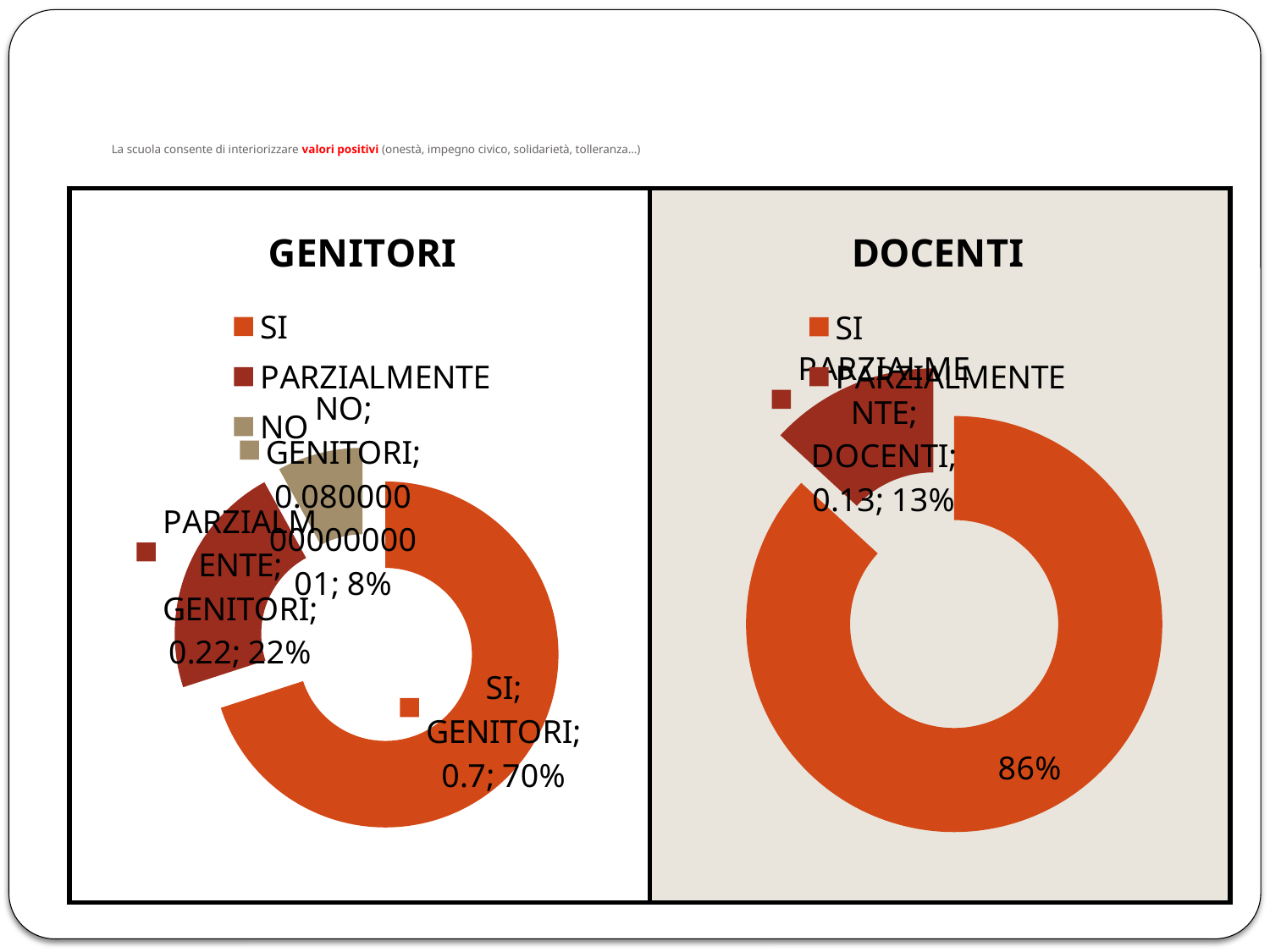
In the GENITORI chart, what is the difference in percentage points between PARZIALMENTE and NO? 14 How many entries does the legend of the GENITORI chart list? 3 In the GENITORI chart, what percentage is shown for PARZIALMENTE? 22% Which chart shows a larger share for PARZIALMENTE, GENITORI or DOCENTI? GENITORI What is the difference in percentage points between SI in the DOCENTI chart and SI in the GENITORI chart? 16 In the DOCENTI chart, what percentage is shown for SI? 86% In the DOCENTI chart, what percentage is shown for PARZIALMENTE? 13% What type of chart is the DOCENTI chart? Doughnut chart In the GENITORI chart, what percentage is shown for SI? 70% In the GENITORI chart, which category has the smallest share? NO In the GENITORI chart, which category has the largest share? SI In the GENITORI chart, what percentage is shown for NO? 8%